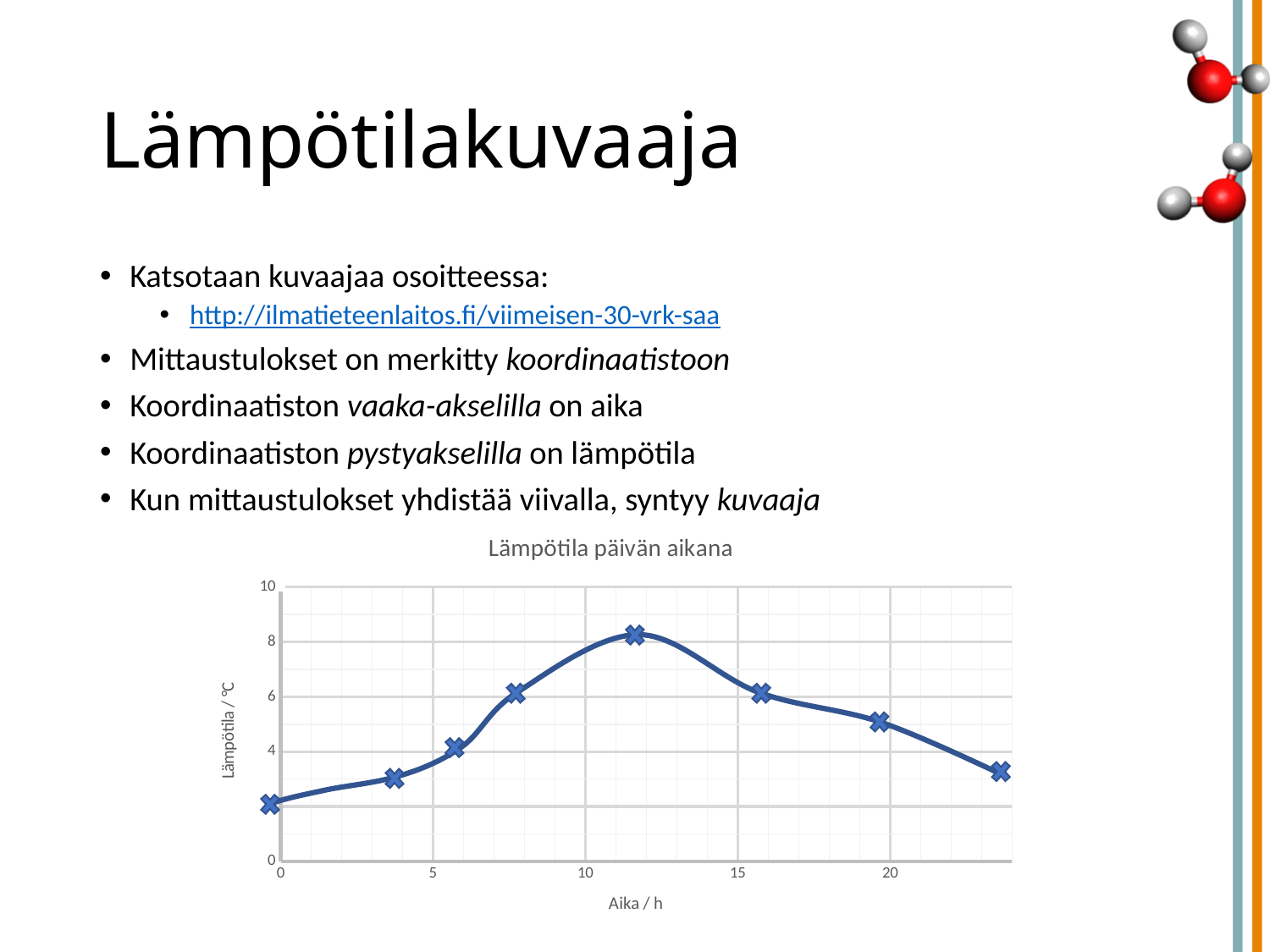
Is the temperature at the data point near 20 h greater or less than 4? greater Is the highest temperature on the chart greater or less than 8? greater How many data points are marked on the line? 8 Is the lowest temperature on the chart greater or less than 4? less Does the temperature rise or fall between about 12 h and 24 h? fall What kind of chart is shown on the slide? line chart What is the title of the chart? Lämpötila päivän aikana What is the label of the vertical axis of the chart? Lämpötila / °C Does the temperature rise or fall between 0 h and about 12 h? rise Which is higher: the temperature at the first data point (0 h) or at the last data point (around 24 h)? the last data point